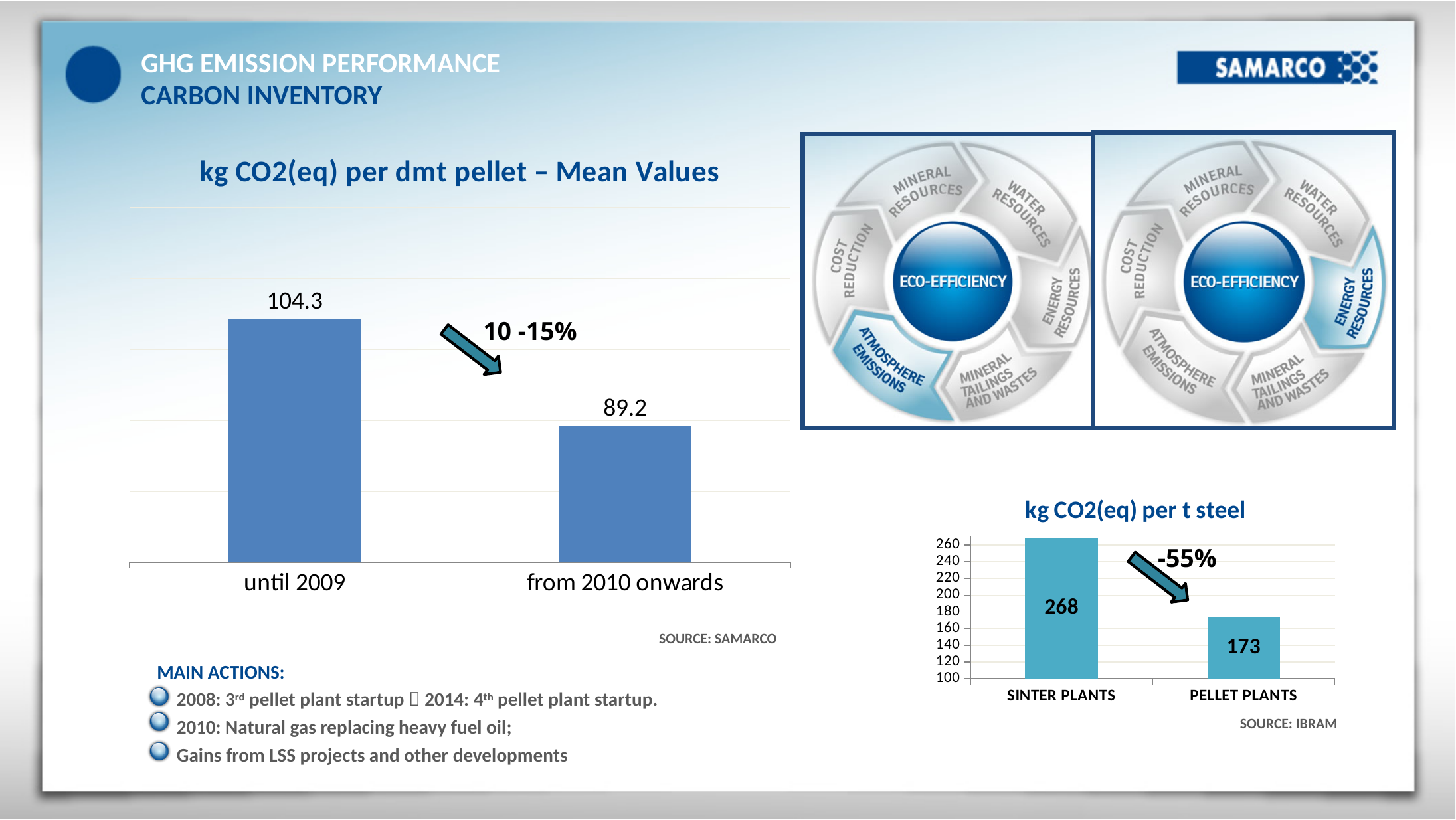
What kind of chart is the 'kg CO2(eq) per dmt pellet – Mean Values' chart? bar chart In the 'kg CO2(eq) per dmt pellet – Mean Values' chart, which category has the higher value? until 2009 In the 'kg CO2(eq) per t steel' chart, which category has the lowest value? PELLET PLANTS In the 'kg CO2(eq) per t steel' chart, what is the value for PELLET PLANTS? 173 In the 'kg CO2(eq) per dmt pellet – Mean Values' chart, what is the value for 'from 2010 onwards'? 89.2 In the 'kg CO2(eq) per dmt pellet – Mean Values' chart, how many categories are shown? 2 In the 'kg CO2(eq) per t steel' chart, what is the difference between the SINTER PLANTS and PELLET PLANTS values? 95 In the 'kg CO2(eq) per t steel' chart, what percentage change is annotated next to the arrow? -55% In the 'kg CO2(eq) per dmt pellet – Mean Values' chart, what is the value for 'until 2009'? 104.3 In the 'kg CO2(eq) per t steel' chart, what is the value for SINTER PLANTS? 268 In the 'kg CO2(eq) per dmt pellet – Mean Values' chart, what is the difference between the 'until 2009' and 'from 2010 onwards' values? 15.1 In the 'kg CO2(eq) per t steel' chart, is the value for PELLET PLANTS greater or less than 200? less